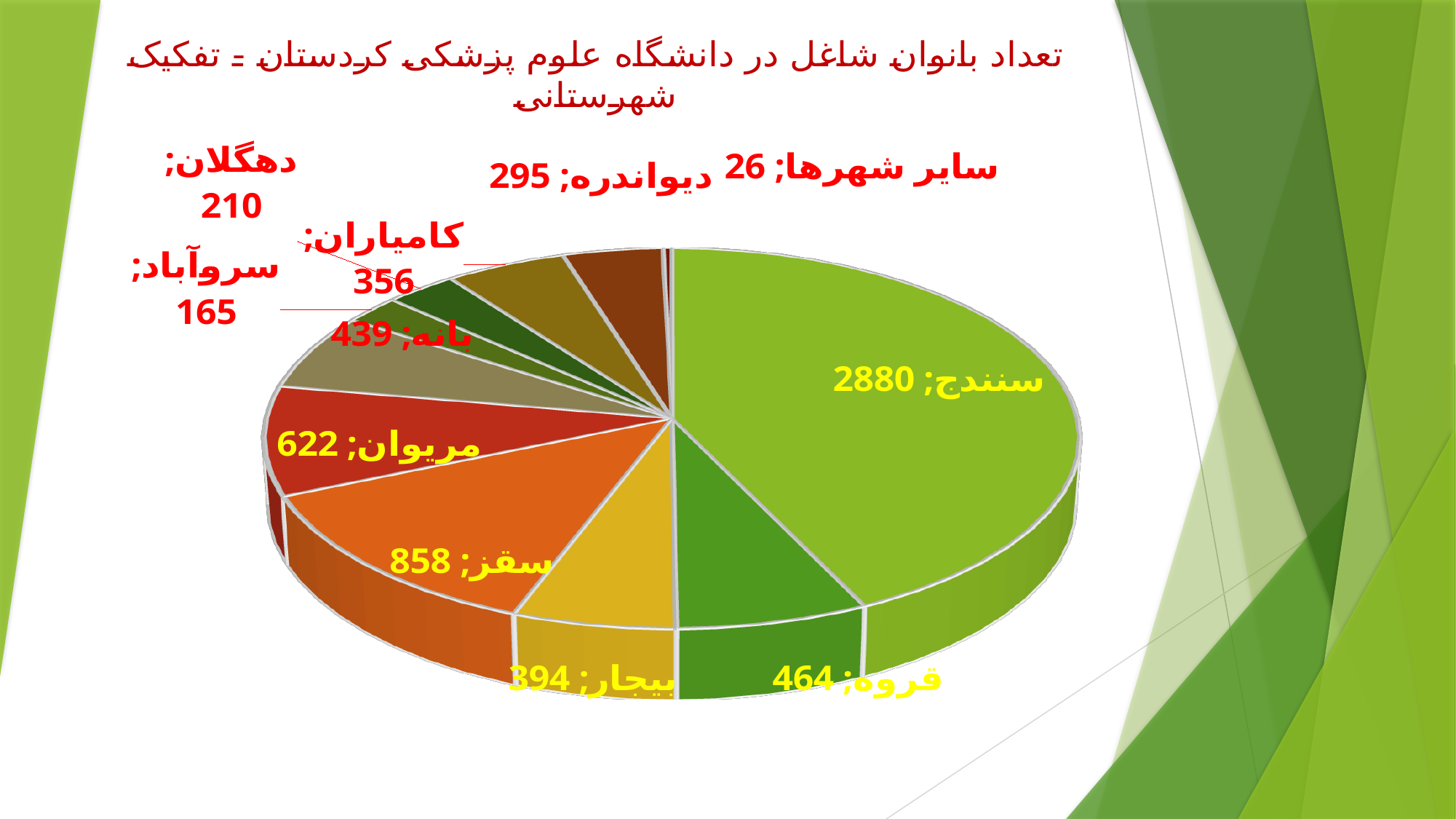
Which category has the smallest slice in the pie chart? سایر شهرها What is the difference between the values for سقز and مریوان? 236 What is the value for مریوان in the pie chart? 622 Which is larger, the value for قروه or the value for بانه? قروه What kind of chart is shown on the slide? pie chart What is the value for سایر شهرها in the pie chart? 26 What is the value for سقز in the pie chart? 858 What is the value for سنندج in the pie chart? 2880 What is the difference between the values for کامیاران and دیواندره? 61 How many categories (slices) does the pie chart have? 11 Which category has the largest slice in the pie chart? سنندج What is the value for سروآباد in the pie chart? 165